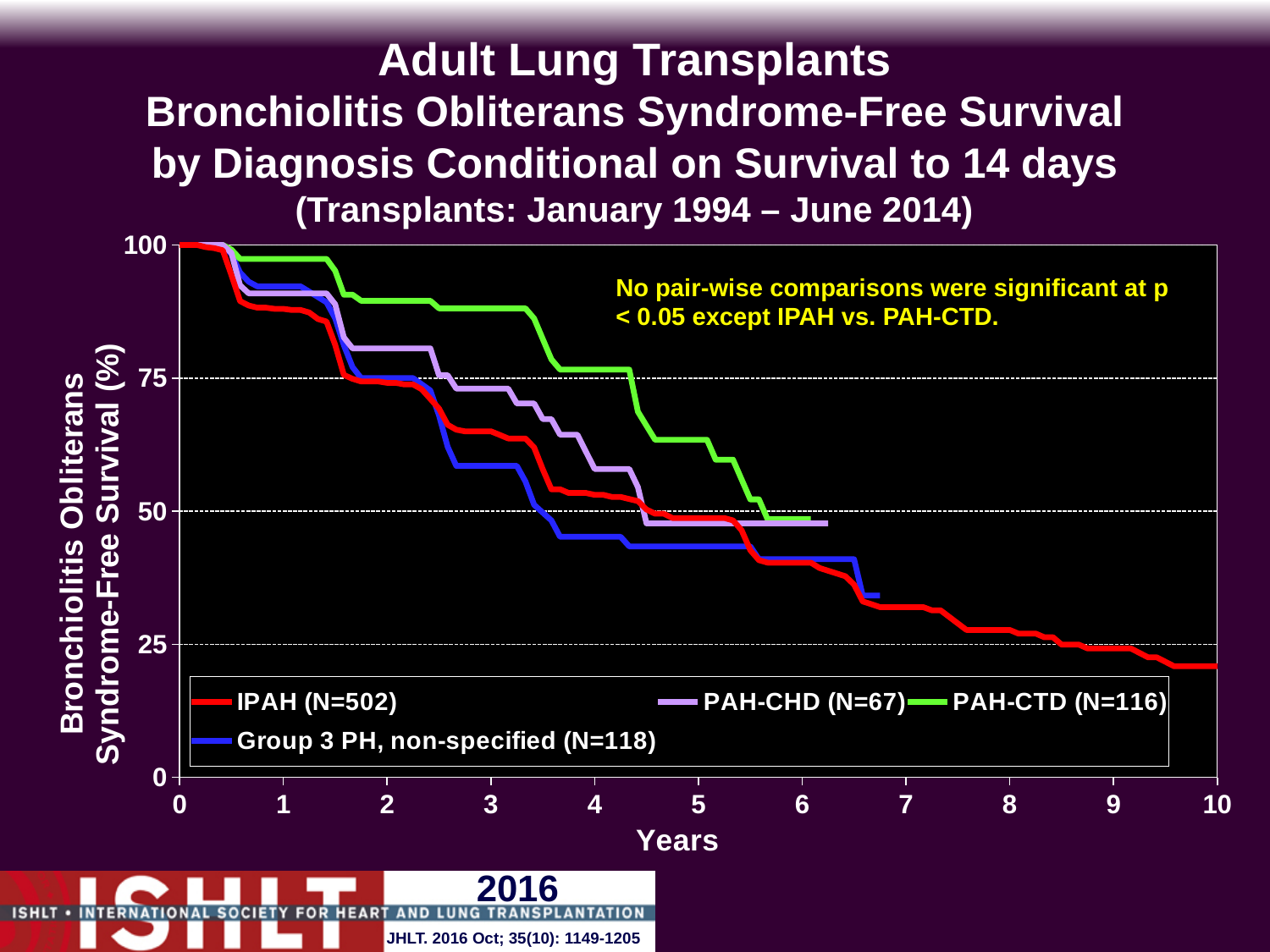
What kind of chart is shown on the slide? line chart At 3 years, which series has the higher value, PAH-CHD or Group 3 PH, non-specified? PAH-CHD Do the survival curves rise or fall as years increase along the x axis? fall At 5 years, which series has the higher value, PAH-CTD or IPAH? PAH-CTD How many series does the legend list? 4 Which series in the legend has N=502? IPAH Is the value for IPAH at 1 year greater or less than 75? greater Is the value for IPAH at 10 years greater or less than 25? less Is the value for PAH-CHD at 2 years greater or less than 75? greater What is the N shown in the legend for PAH-CTD? 116